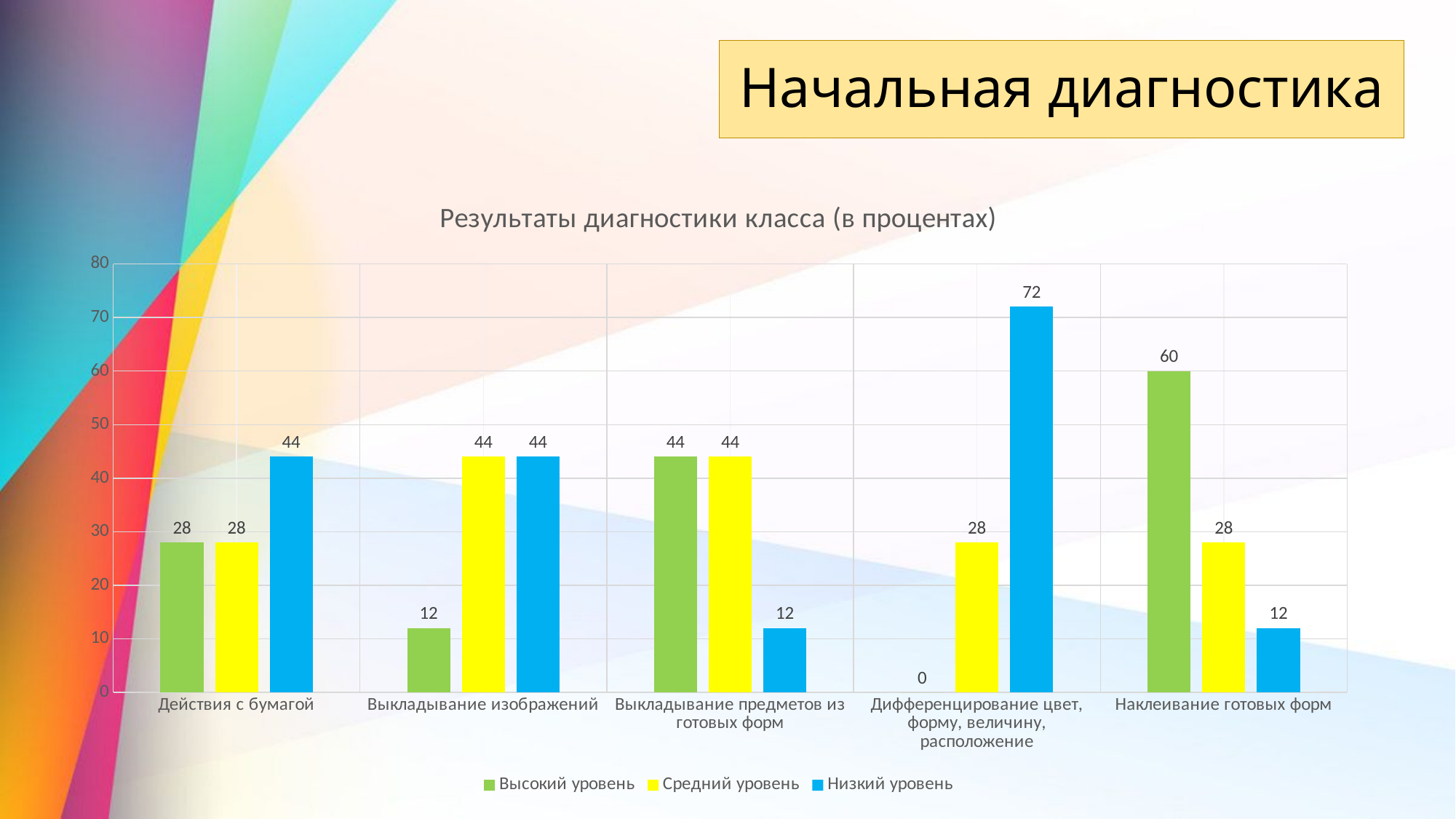
Which category has the lowest Высокий уровень value? Дифференцирование цвет, форму, величину, расположение Which category has the highest Низкий уровень value? Дифференцирование цвет, форму, величину, расположение What is the value of Низкий уровень for Дифференцирование цвет, форму, величину, расположение? 72 How many categories are shown on the x axis? 5 What kind of chart is shown on the slide? Bar chart How many series does the legend list? 3 What is the value of Высокий уровень for Дифференцирование цвет, форму, величину, расположение? 0 What is the difference between the Низкий уровень and Высокий уровень values for Наклеивание готовых форм? 48 What is the value of Средний уровень for Выкладывание изображений? 44 What is the value of Высокий уровень for Наклеивание готовых форм? 60 What is the title of the chart? Результаты диагностики класса (в процентах) For Выкладывание изображений, which is larger: Высокий уровень or Средний уровень? Средний уровень